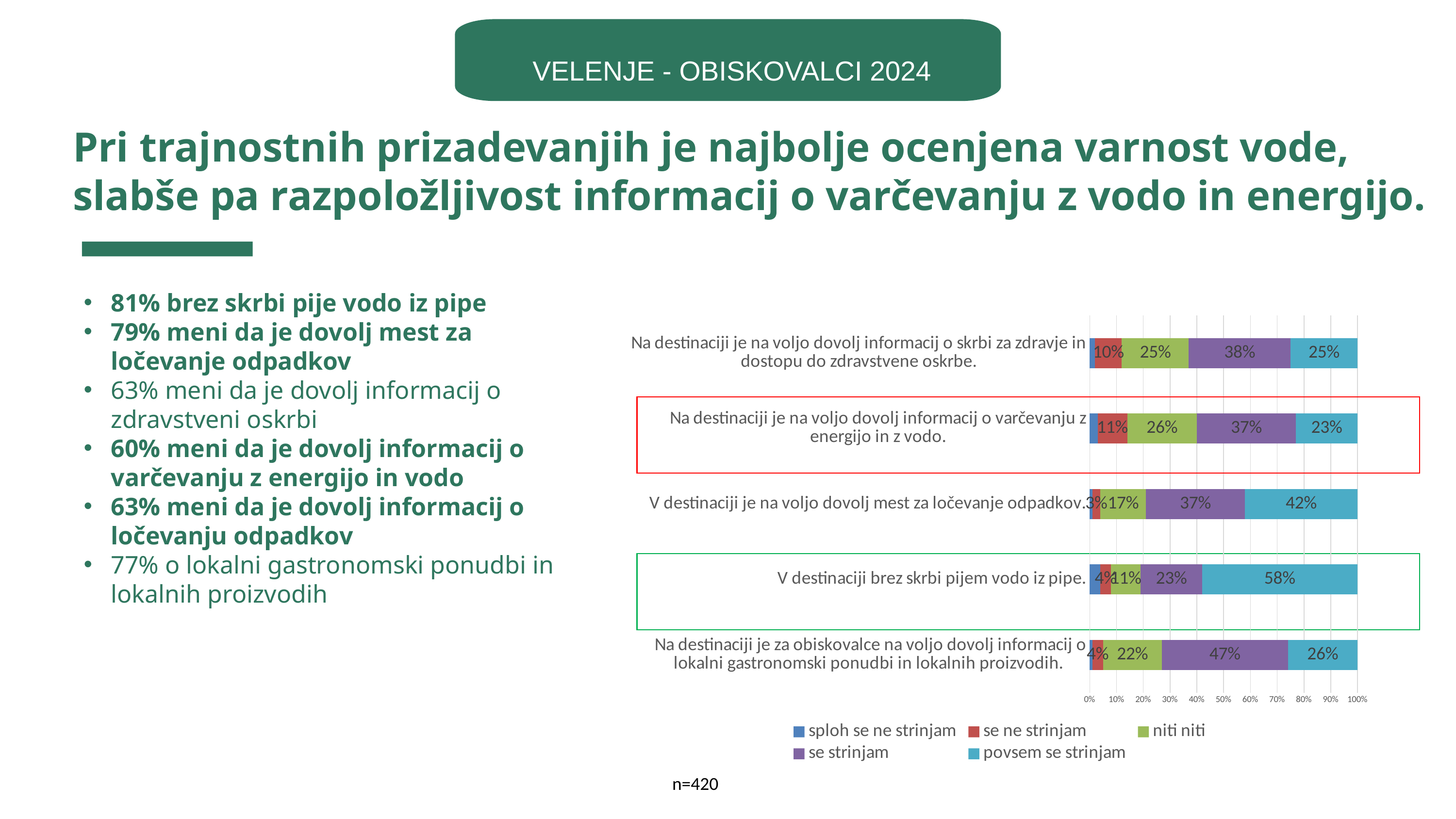
What is the 'povsem se strinjam' value for 'V destinaciji je na voljo dovolj mest za ločevanje odpadkov.'? 42% What kind of chart is shown on the slide? stacked bar chart Which is larger: the 'se ne strinjam' value for the health information statement or for the energy and water saving statement? the energy and water saving statement (11%) What is the 'povsem se strinjam' value for 'V destinaciji brez skrbi pijem vodo iz pipe.'? 58% What is the difference between the 'se strinjam' values for the local gastronomy statement (47%) and the water-from-tap statement (23%)? 24% How many statements (categories) are plotted in the chart? 5 Which legend entry is shown in purple? se strinjam How many series does the chart legend list? 5 Which statement has the highest 'povsem se strinjam' value? V destinaciji brez skrbi pijem vodo iz pipe. What is the 'se strinjam' value for 'Na destinaciji je za obiskovalce na voljo dovolj informacij o lokalni gastronomski ponudbi in lokalnih proizvodih.'? 47% Which statement has the lowest 'povsem se strinjam' value? Na destinaciji je na voljo dovolj informacij o varčevanju z energijo in z vodo. What is the 'niti niti' value for 'Na destinaciji je na voljo dovolj informacij o varčevanju z energijo in z vodo.'? 26%